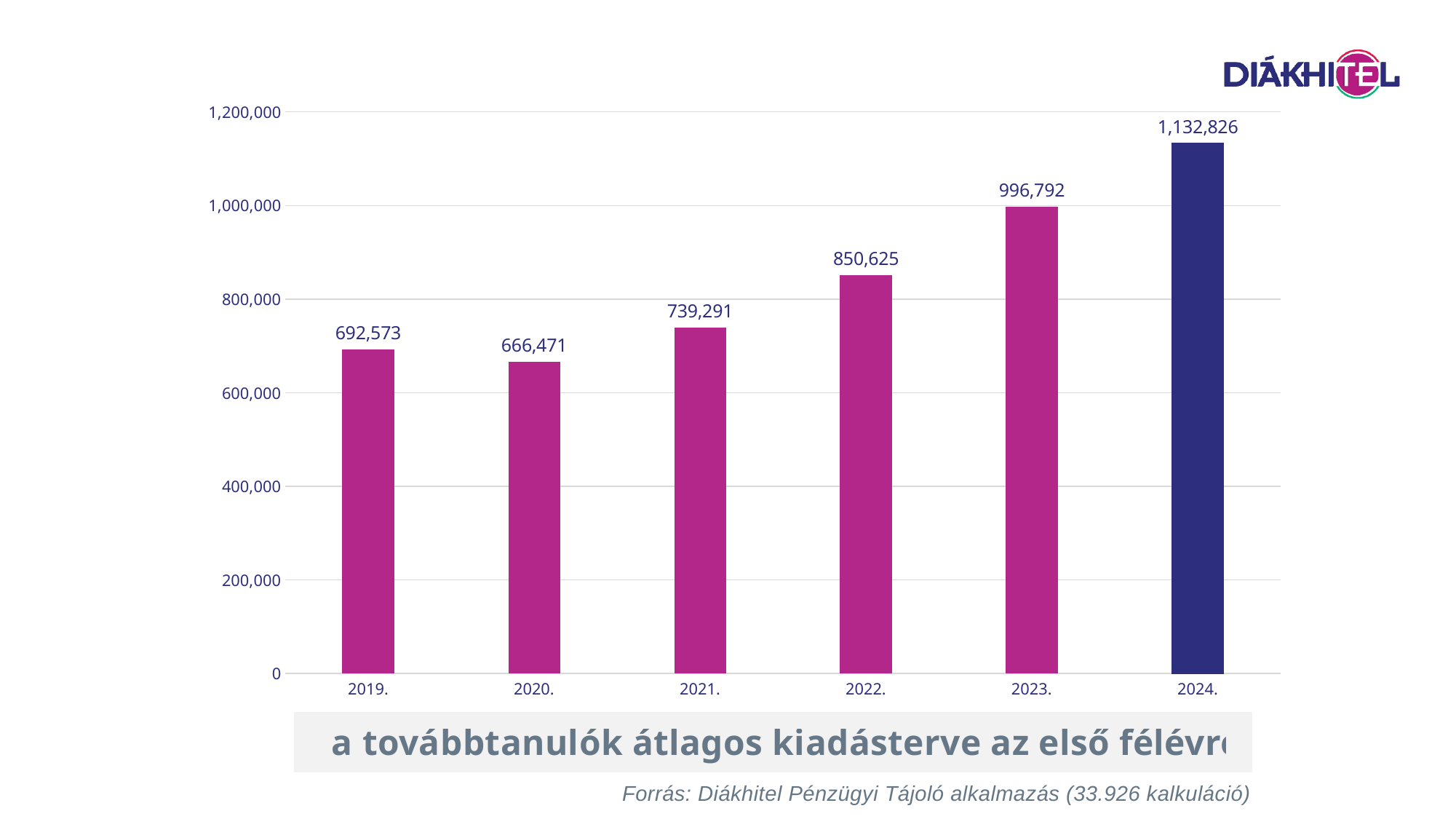
What colour is the bar for 2024 compared with the other bars? dark blue, the others are magenta What kind of chart is shown on the slide? bar chart What is the difference between the values for 2024 and 2023? 136,034 How many years are shown on the x axis? 6 What is the difference between the values for 2019 and 2020? 26,102 What is the value for 2024? 1,132,826 Which year has the highest value? 2024. What is the value for 2022? 850,625 Is the value for 2023 greater or less than 800,000? greater Which is larger, the value for 2021 or the value for 2022? 2022 Which year has the lowest value? 2020. What is the value for 2019? 692,573